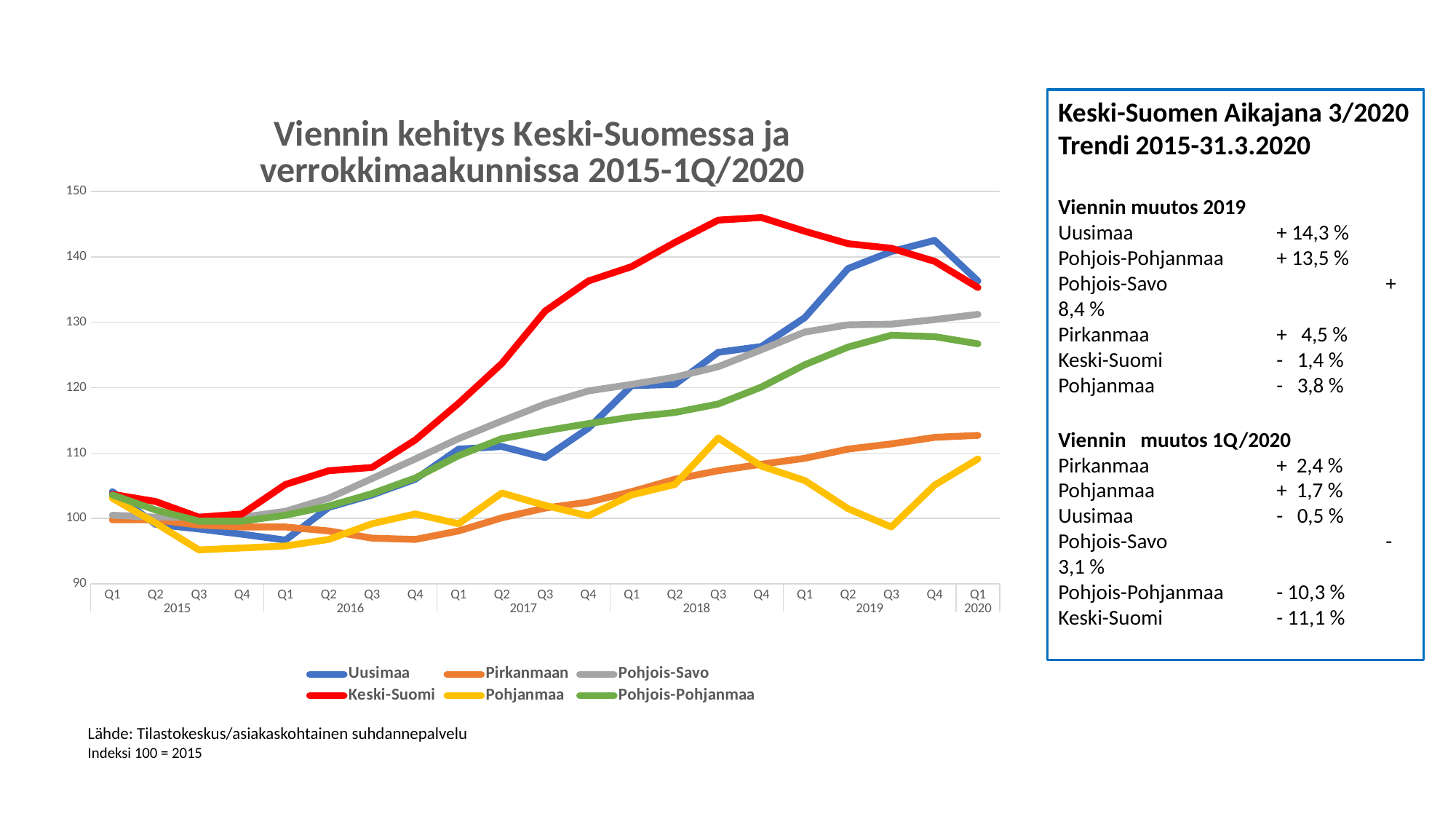
How many quarterly points are plotted along the x axis of the chart? 21 Is the value for Keski-Suomi at Q4 2018 greater or less than 140? greater Is the value for Pohjois-Pohjanmaa at Q1 2020 greater or less than 130? less How many series does the chart legend list? 6 Which series has the lowest value at Q3 2015? Pohjanmaa Is the value for Pohjanmaa at Q3 2015 greater or less than 100? less What kind of chart is shown on the slide? line chart Which series has the highest value at Q4 2018? Keski-Suomi What is the title of the chart? Viennin kehitys Keski-Suomessa ja verrokkimaakunnissa 2015-1Q/2020 At Q3 2018, which is larger: the value for Keski-Suomi or the value for Pirkanmaa? Keski-Suomi Does the Keski-Suomi line rise or fall from Q4 2018 to Q1 2020? fall Which series has the lowest value at Q1 2020? Pohjanmaa